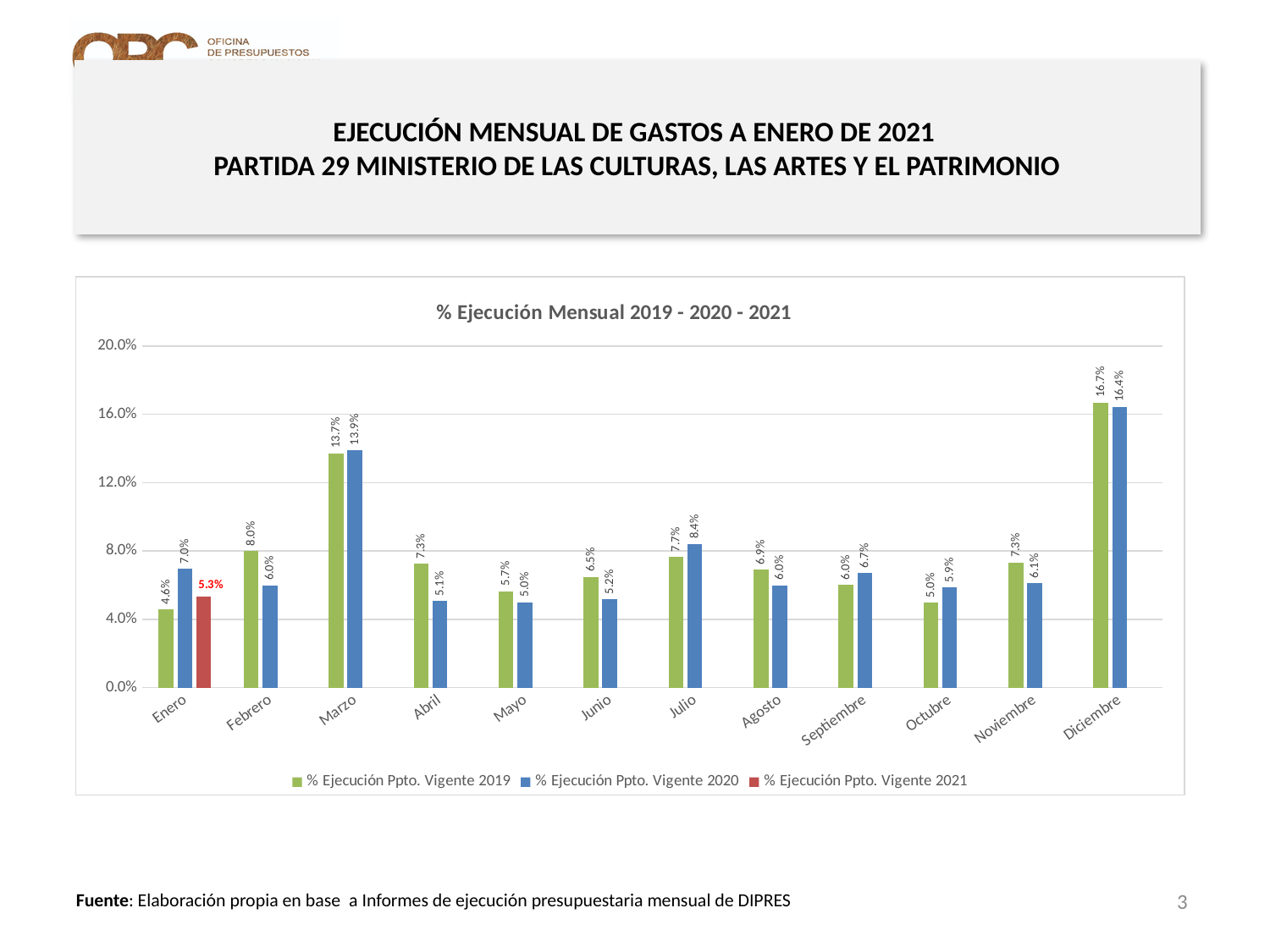
What is the difference between the 2020 and 2019 values in Enero? 2.4% What kind of chart is shown? Bar chart What is the title of the chart? % Ejecución Mensual 2019 - 2020 - 2021 What is the value for % Ejecución Ppto. Vigente 2019 in Marzo? 13.7% Which month has the lowest value for % Ejecución Ppto. Vigente 2020? Mayo In Abril, which series has the larger value, % Ejecución Ppto. Vigente 2019 or % Ejecución Ppto. Vigente 2020? % Ejecución Ppto. Vigente 2019 How many series does the legend list? 3 Which month has the highest value for % Ejecución Ppto. Vigente 2019? Diciembre Is the value for % Ejecución Ppto. Vigente 2020 in Diciembre greater or less than 12.0%? greater What is the value for % Ejecución Ppto. Vigente 2020 in Julio? 8.4% How many months are shown on the x axis? 12 What is the value for % Ejecución Ppto. Vigente 2021 in Enero? 5.3%